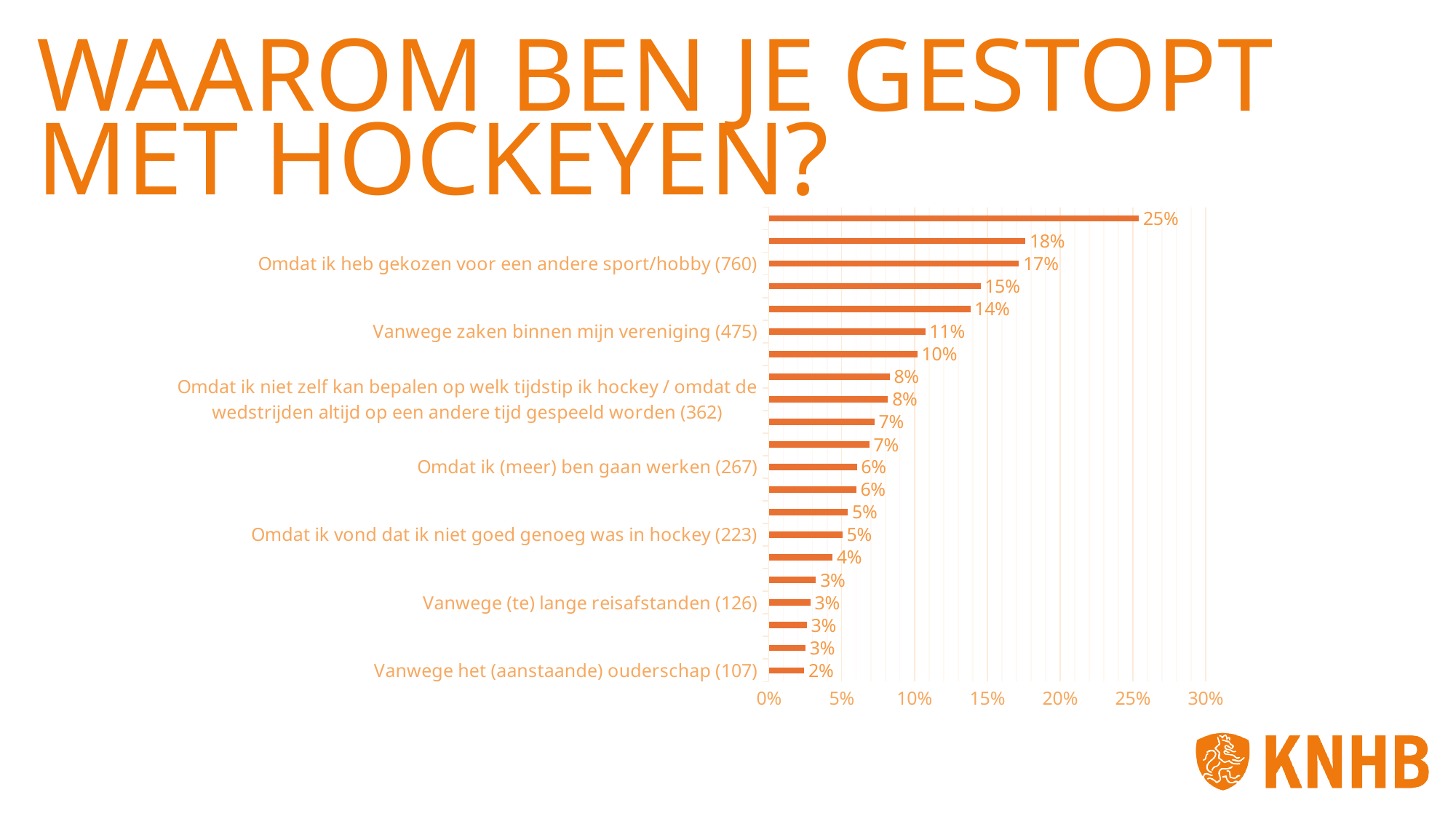
What percentage is shown for "Omdat ik vond dat ik niet goed genoeg was in hockey (223)"? 5% What percentage is shown for "Vanwege (te) lange reisafstanden (126)"? 3% What percentage is shown for "Omdat ik (meer) ben gaan werken (267)"? 6% What is the highest percentage shown on the chart? 25% What percentage is shown for "Vanwege het (aanstaande) ouderschap (107)"? 2% What percentage is shown for "Omdat ik heb gekozen voor een andere sport/hobby (760)"? 17% What is the difference in percentage points between "Omdat ik heb gekozen voor een andere sport/hobby (760)" and "Vanwege zaken binnen mijn vereniging (475)"? 6 percentage points What percentage is shown for "Vanwege zaken binnen mijn vereniging (475)"? 11% How many bars are plotted on the chart? 21 What type of chart is shown on the slide? Bar chart Which labelled category has the lowest percentage? Vanwege het (aanstaande) ouderschap (107) Which is larger: the value for "Omdat ik (meer) ben gaan werken (267)" or for "Vanwege (te) lange reisafstanden (126)"? Omdat ik (meer) ben gaan werken (267)